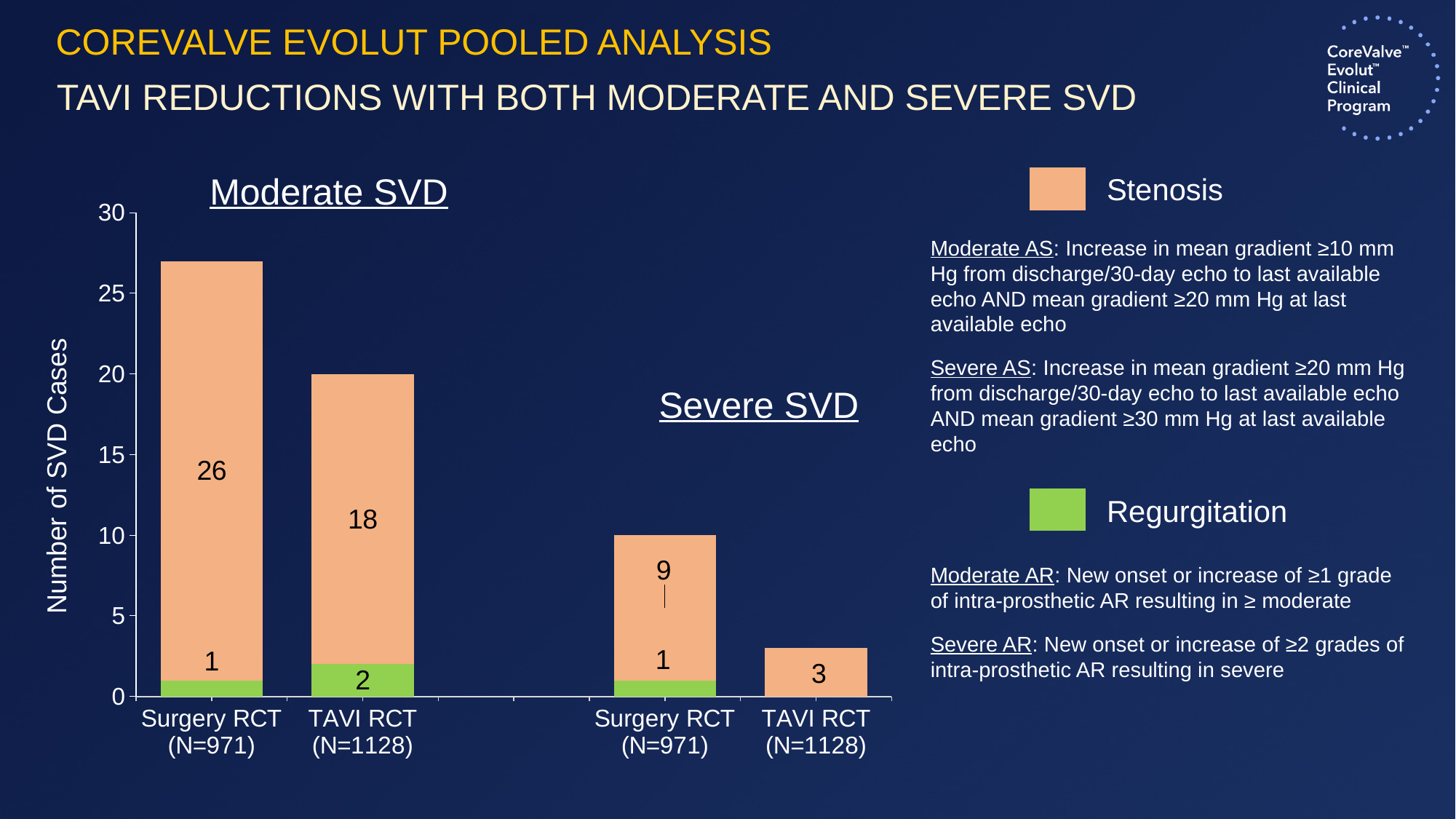
What is the Stenosis value for TAVI RCT under Moderate SVD? 18 Which bar has the highest total number of SVD cases? Surgery RCT (Moderate SVD) What is the Stenosis value for Surgery RCT under Moderate SVD? 26 What is the difference in Stenosis cases between Surgery RCT and TAVI RCT under Severe SVD? 6 What is the Stenosis value for TAVI RCT under Severe SVD? 3 What is the total number of SVD cases for the TAVI RCT bar under Moderate SVD? 20 What is the Regurgitation value for TAVI RCT under Moderate SVD? 2 What is the Stenosis value for Surgery RCT under Severe SVD? 9 How many series does the legend list? 2 Which has more Stenosis cases under Moderate SVD, Surgery RCT or TAVI RCT? Surgery RCT What type of chart is shown on the slide? Stacked bar chart What is the total number of SVD cases for the Surgery RCT bar under Moderate SVD? 27